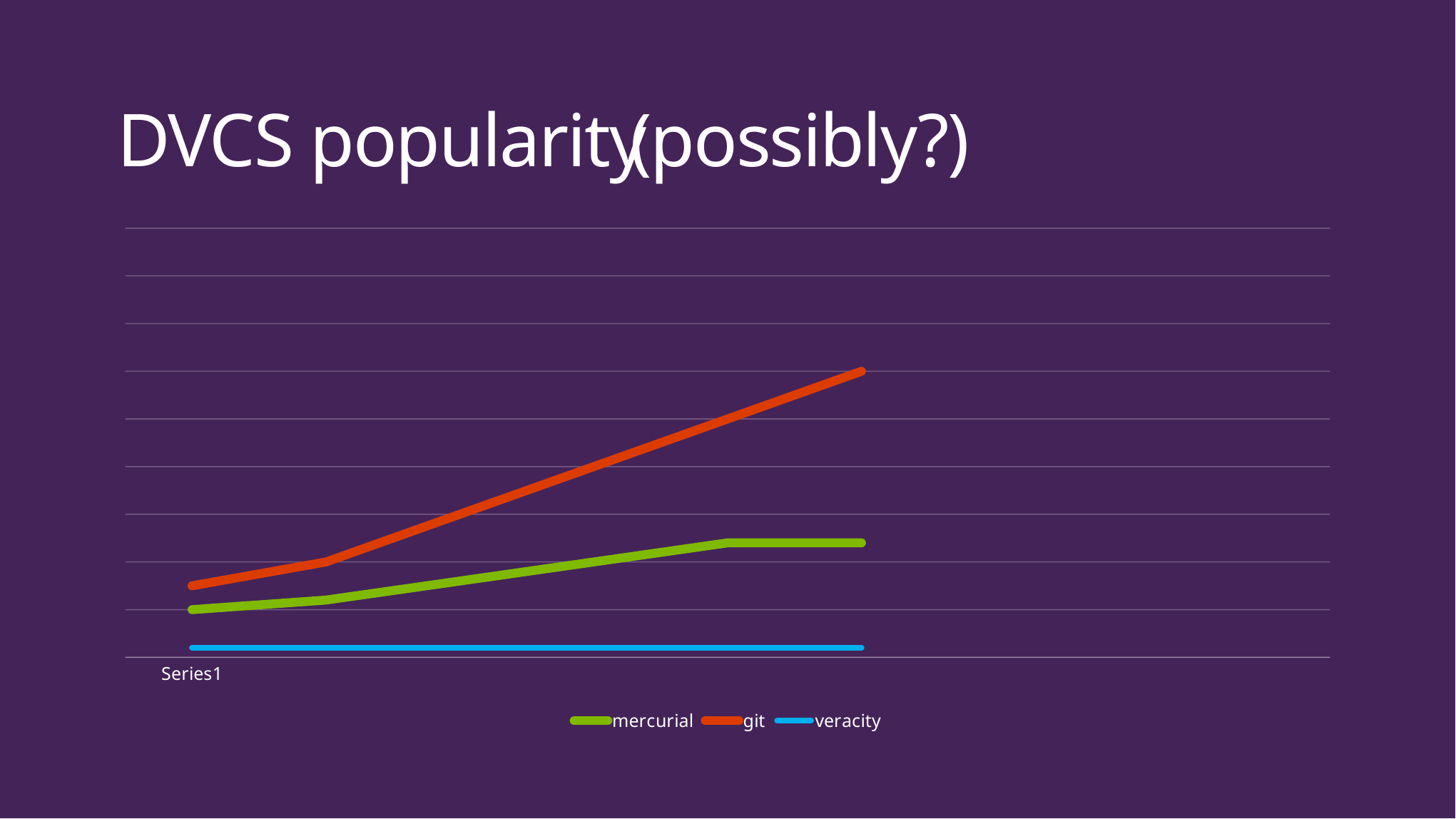
What colour is the git line? red What kind of chart is shown on the slide? line chart How many series does the legend list? 3 At the right end of the chart, which is higher: git or mercurial? git What is the title of the slide? DVCS popularity (possibly?) Does the mercurial line rise or fall along the x axis? rise Which series has the lowest values on the chart? veracity Does the veracity line rise, fall, or stay flat along the x axis? stay flat How many data points does each line have? 6 Which series reaches the highest value on the chart? git Does the git line rise or fall along the x axis? rise At the left end of the chart, which is higher: mercurial or veracity? mercurial